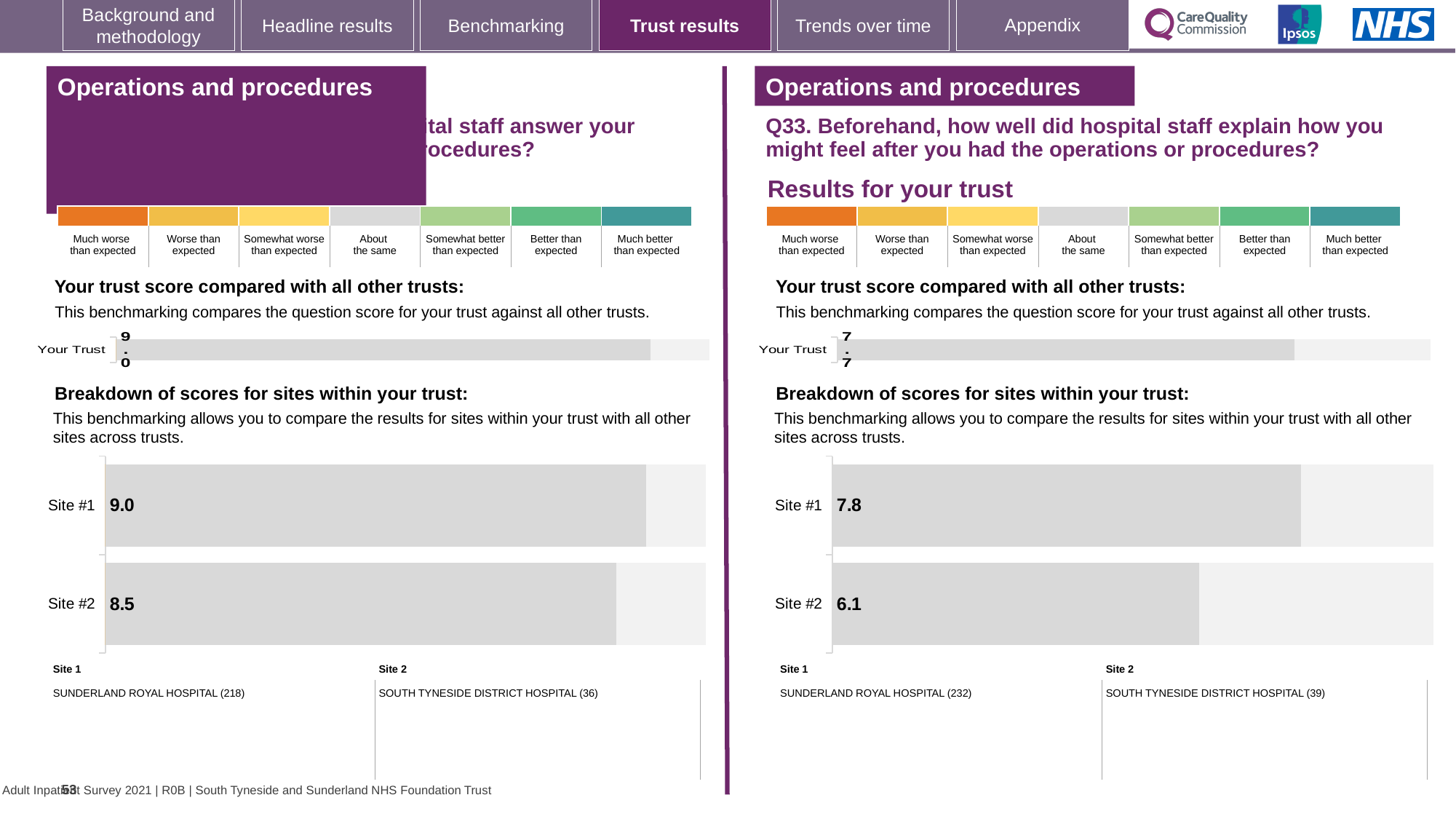
On the left half of the slide, what is the score shown for Site #1 in the breakdown of scores for sites within your trust? 9.0 On the left half of the slide, which site has the lower score in the site breakdown chart? Site #2 On the right half of the slide (Q33), what is the score shown for Site #1 in the breakdown of scores for sites within your trust? 7.8 On the left half of the slide, what is the difference between the Site #1 and Site #2 scores in the site breakdown chart? 0.5 How many sites are shown in the site breakdown chart on the right half of the slide (Q33)? 2 On the left half of the slide, what is the 'Your Trust' score in the chart comparing your trust with all other trusts? 9.0 On the right half of the slide (Q33), which site has the higher score in the site breakdown chart? Site #1 On the right half of the slide (Q33), what is the 'Your Trust' score in the chart comparing your trust with all other trusts? 7.7 On the right half of the slide (Q33), what is the difference between the Site #1 and Site #2 scores in the site breakdown chart? 1.7 What kind of chart is used for the breakdown of scores for sites on the left half of the slide? Bar chart On the right half of the slide (Q33), what is the score shown for Site #2 in the breakdown of scores for sites within your trust? 6.1 On the left half of the slide, what is the score shown for Site #2 in the breakdown of scores for sites within your trust? 8.5